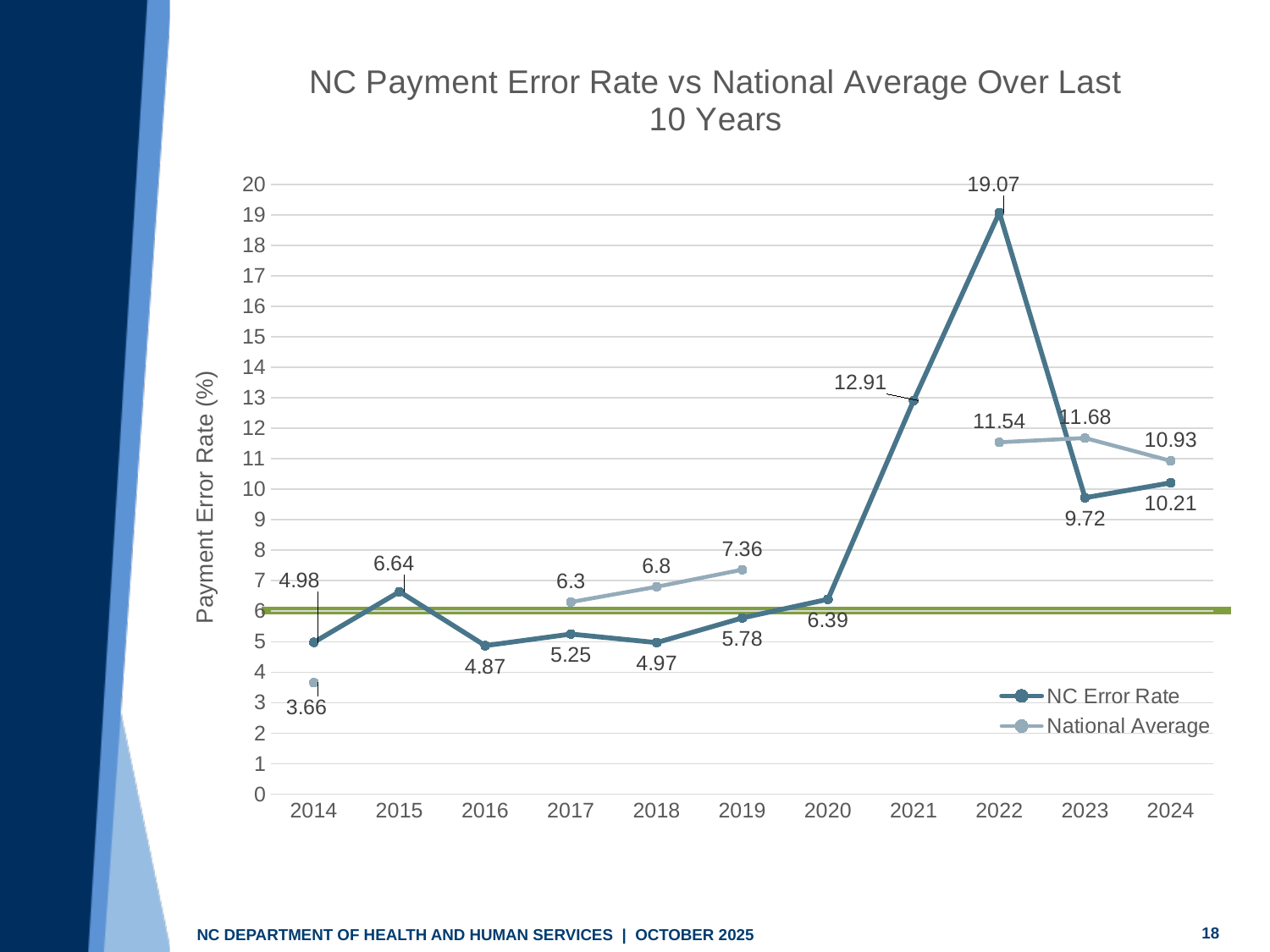
In which year is the NC Error Rate lowest? 2016 What is the National Average value for 2014? 3.66 How many years are shown on the x axis? 11 Does the NC Error Rate rise or fall from 2022 to 2023? fall Which is larger in 2023, the NC Error Rate or the National Average? National Average Is the NC Error Rate for 2021 greater or less than 10? greater In which year is the NC Error Rate highest? 2022 How many series does the legend list? 2 What is the difference between the NC Error Rate and the National Average in 2022? 7.53 What kind of chart is shown on the slide? line chart What is the NC Error Rate for 2022? 19.07 What is the National Average value for 2019? 7.36